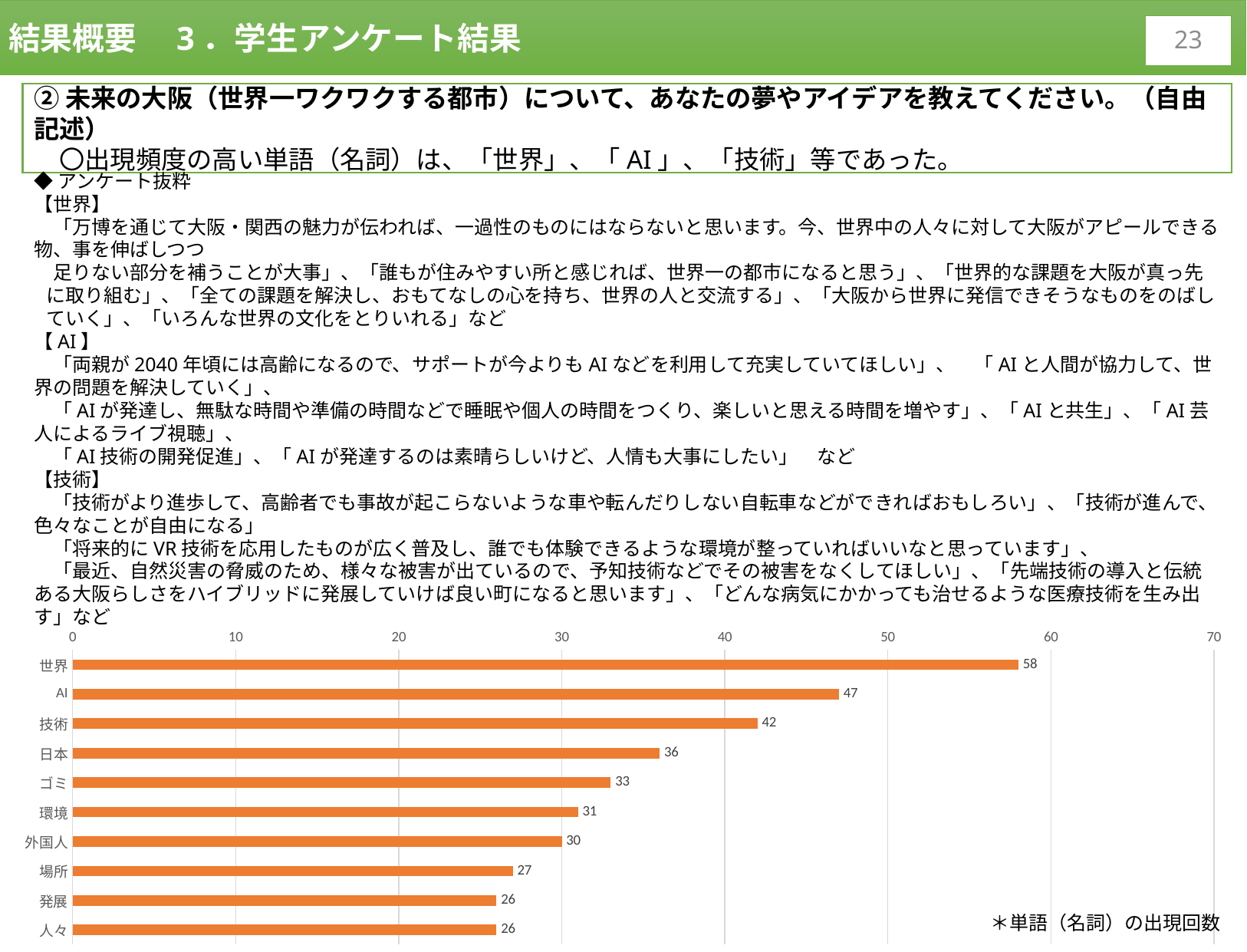
What kind of chart is shown on the slide? bar chart What is the maximum value shown on the chart's horizontal axis? 70 What is the value for AI in the bar chart? 47 What is the difference between the values for 日本 and 環境? 5 Is the value for 技術 greater or less than 40? greater Which category has the highest value in the bar chart? 世界 What is the value for ゴミ in the bar chart? 33 How many categories are shown in the bar chart? 10 What is the difference between the values for 世界 and AI? 11 What is the value for 世界 in the bar chart? 58 Which is larger, the value for 外国人 or the value for 場所? 外国人 What is the value for 技術 in the bar chart? 42